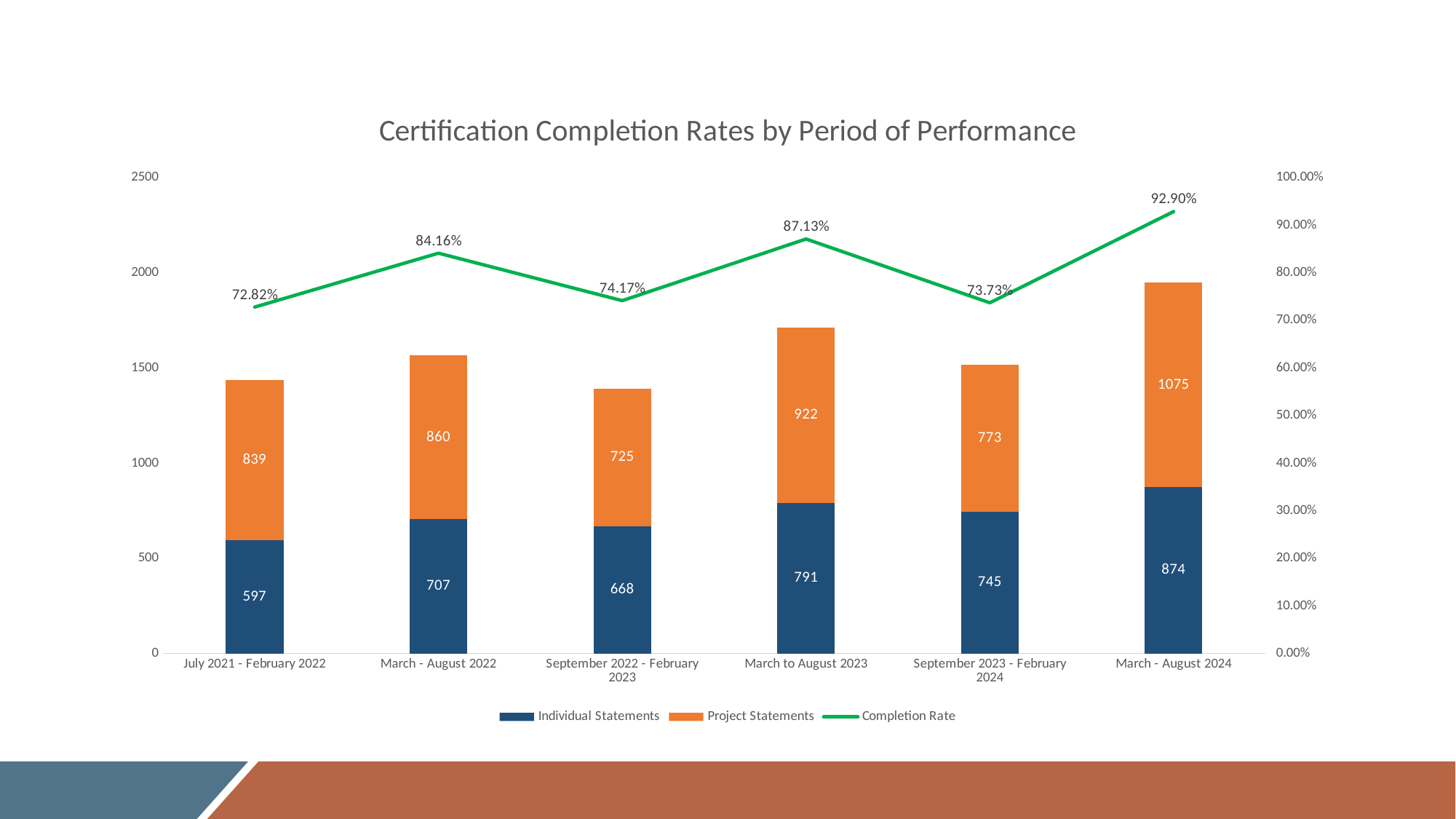
What is the value of Individual Statements for March - August 2022? 707 Which period has the lowest value for Individual Statements? July 2021 - February 2022 What is the total of the stacked bar for March to August 2023? 1713 What is the difference between Project Statements and Individual Statements for March - August 2024? 201 What is the Completion Rate for September 2023 - February 2024? 73.73% How many series does the legend list? 3 How many periods are shown on the x axis? 6 What is the title of the chart? Certification Completion Rates by Period of Performance What kind of chart is this? Stacked bar chart with a line Which period has the highest Completion Rate? March - August 2024 What is the value of Project Statements for March to August 2023? 922 Which is larger: Project Statements for July 2021 - February 2022 or Project Statements for September 2022 - February 2023? July 2021 - February 2022